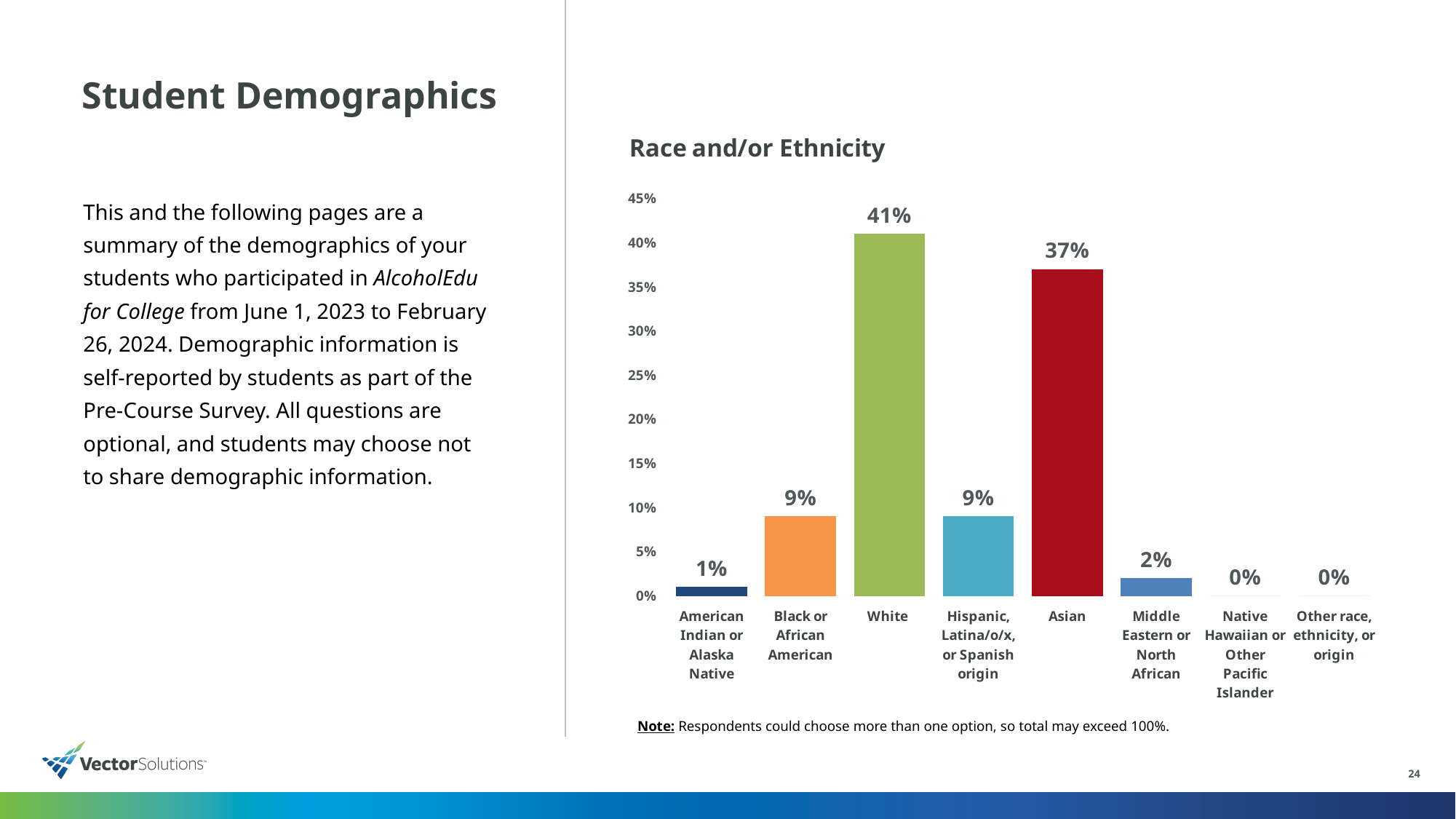
What percentage of students identified as Asian? 37% Which race/ethnicity category has the highest value? White Which is larger, the value for Black or African American or the value for Middle Eastern or North African? Black or African American What is the value for American Indian or Alaska Native? 1% What is the difference between the White and Asian percentages? 4% Is the value for Asian greater or less than 35%? greater What percentage of students identified as White? 41% How many categories show a value of 0%? 2 What kind of chart is used to show race and/or ethnicity? bar chart What is the value for Middle Eastern or North African? 2% How many race/ethnicity categories are shown on the chart? 8 What is the title of the chart? Race and/or Ethnicity